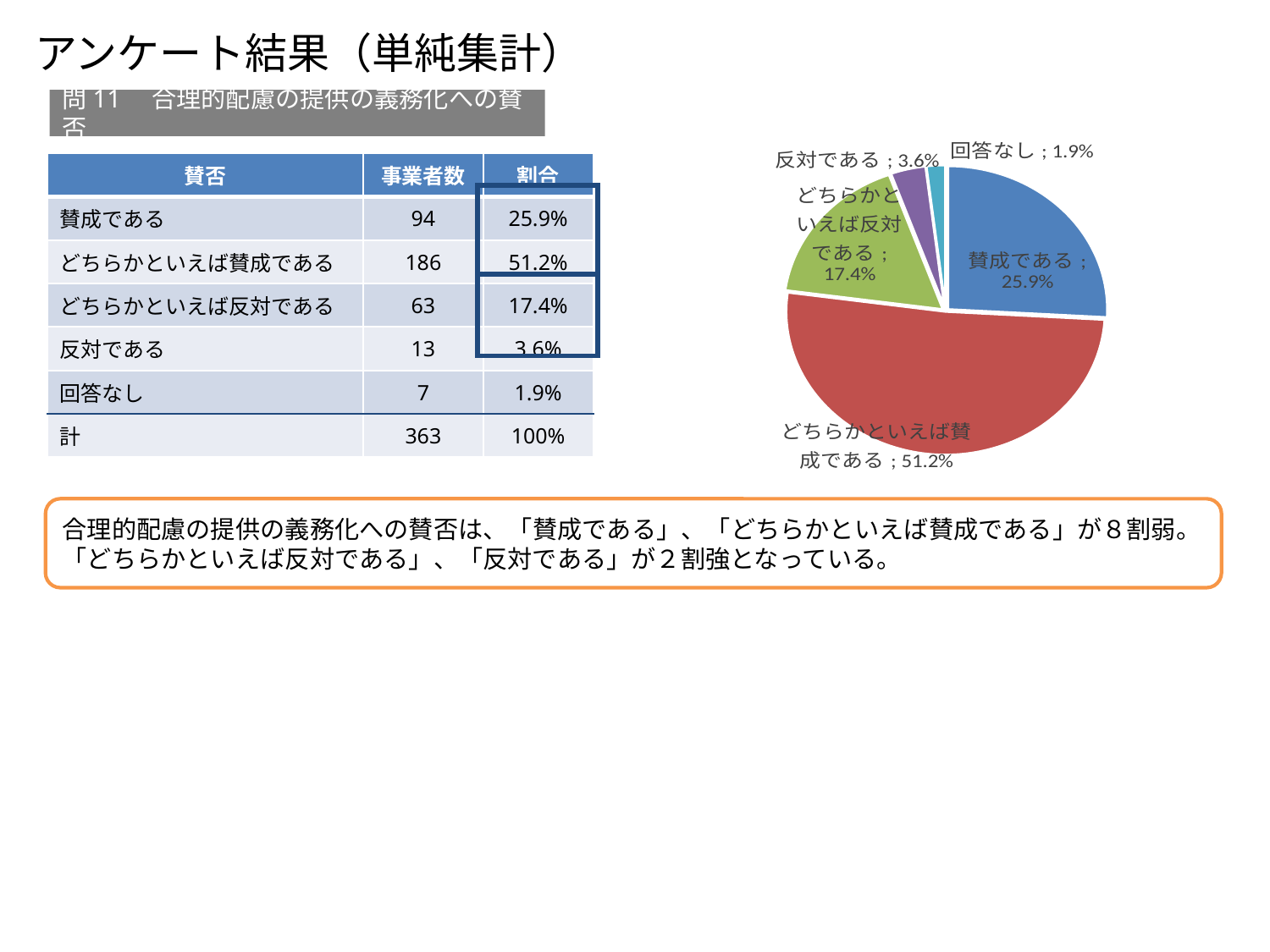
Which category has the smallest slice in the pie chart? 回答なし What kind of chart is shown on the slide? pie chart Which category has the largest slice in the pie chart? どちらかといえば賛成である What share of the pie does 「賛成である」 represent? 25.9% What share of the pie does 「どちらかといえば反対である」 represent? 17.4% What share of the pie does 「どちらかといえば賛成である」 represent? 51.2% What colour is the 「どちらかといえば賛成である」 slice in the pie chart? red What is the difference in percentage points between 「どちらかといえば賛成である」 and 「賛成である」? 25.3 Which is larger in the pie chart, 「賛成である」 or 「どちらかといえば反対である」? 賛成である How many slices does the pie chart have? 5